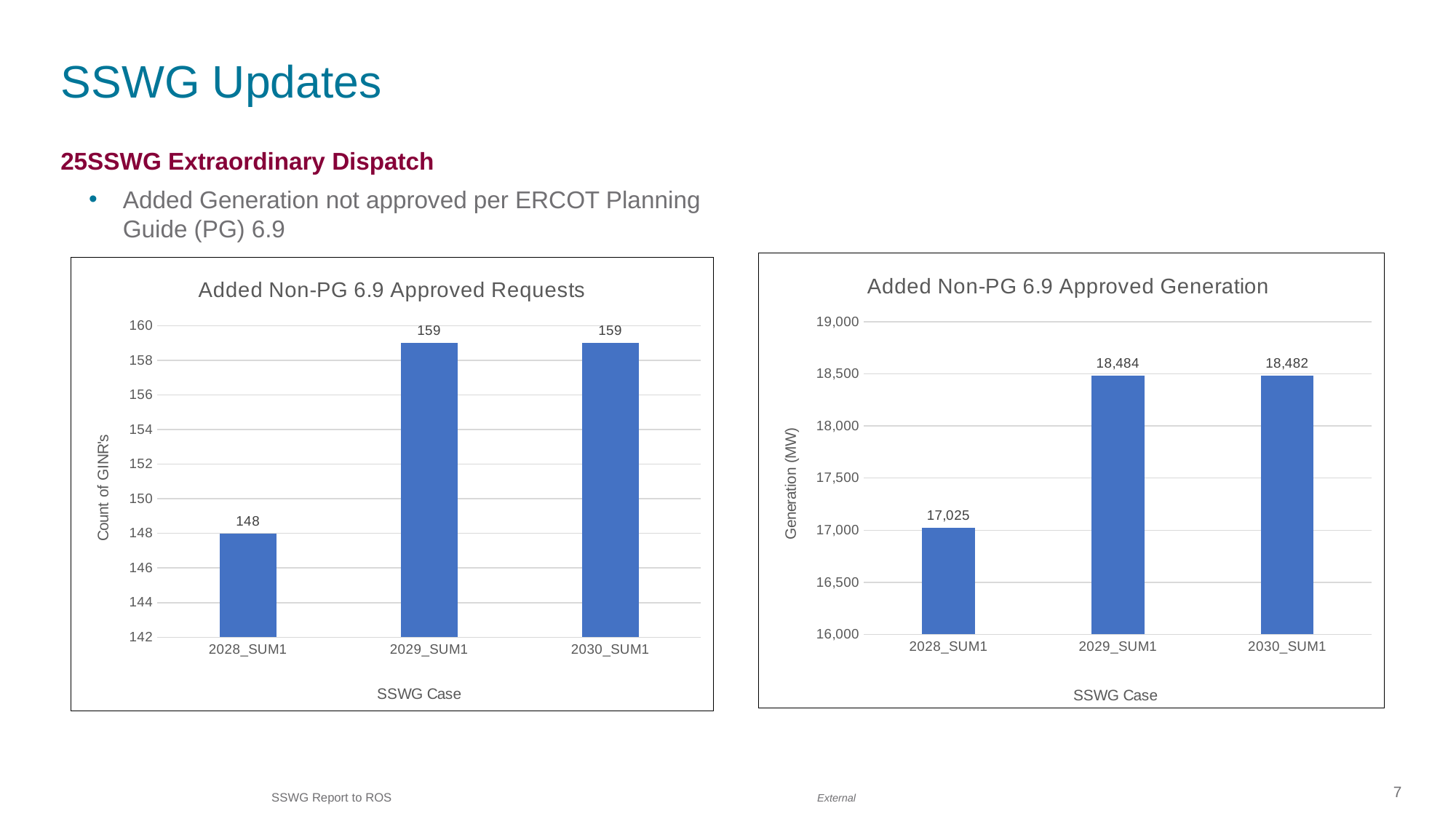
In the 'Added Non-PG 6.9 Approved Generation' chart, which SSWG case has the highest generation? 2029_SUM1 In the 'Added Non-PG 6.9 Approved Requests' chart, what is the difference between the values for 2029_SUM1 and 2028_SUM1? 11 In the 'Added Non-PG 6.9 Approved Requests' chart, what is the value for 2029_SUM1? 159 In the 'Added Non-PG 6.9 Approved Generation' chart, what is the value for 2028_SUM1? 17,025 In the 'Added Non-PG 6.9 Approved Generation' chart, what is the difference between the values for 2029_SUM1 and 2028_SUM1? 1,459 In the 'Added Non-PG 6.9 Approved Requests' chart, how many SSWG cases are shown? 3 What is the y-axis label of the 'Added Non-PG 6.9 Approved Generation' chart? Generation (MW) In the 'Added Non-PG 6.9 Approved Requests' chart, which SSWG case has the lowest count of GINRs? 2028_SUM1 In the 'Added Non-PG 6.9 Approved Requests' chart, what is the value for 2028_SUM1? 148 What kind of chart is the 'Added Non-PG 6.9 Approved Generation' chart? bar chart In the 'Added Non-PG 6.9 Approved Generation' chart, is the value for 2028_SUM1 greater or less than 17,500? less In the 'Added Non-PG 6.9 Approved Generation' chart, what is the value for 2030_SUM1? 18,482